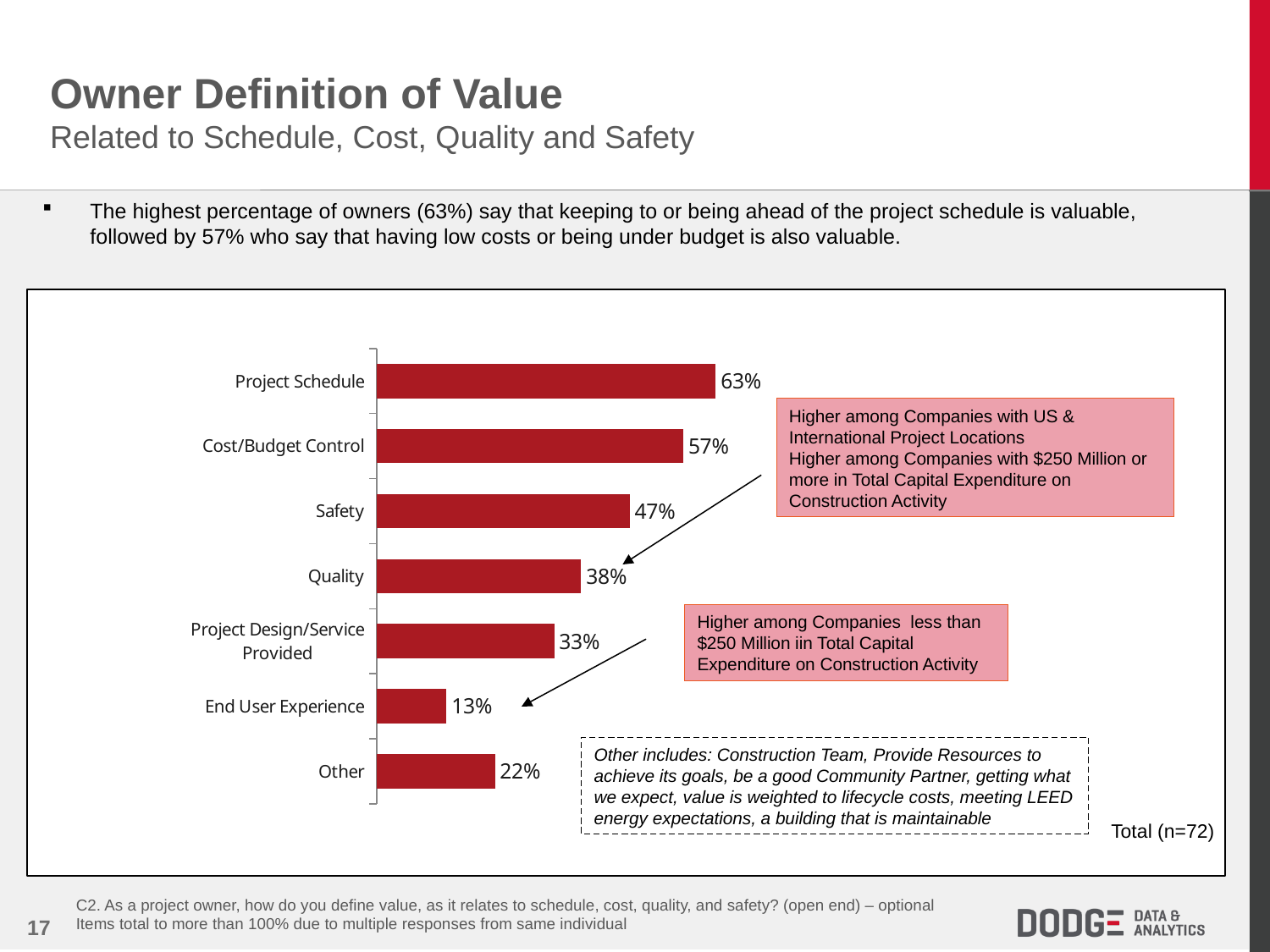
What is the sample size (n) noted on the chart? n=72 What is the value for End User Experience? 13% What is the difference between the percentages for Project Schedule and Cost/Budget Control? 6% What percentage of owners cite Project Schedule as part of their definition of value? 63% How many categories are shown in the chart? 7 What is the difference between the values for Quality and Project Design/Service Provided? 5% What is the value shown for Cost/Budget Control? 57% What percentage is shown for Safety? 47% Which category has the highest percentage? Project Schedule What type of chart is shown on the slide? Bar chart Which is larger, the value for Other or the value for End User Experience? Other Which category has the lowest percentage? End User Experience